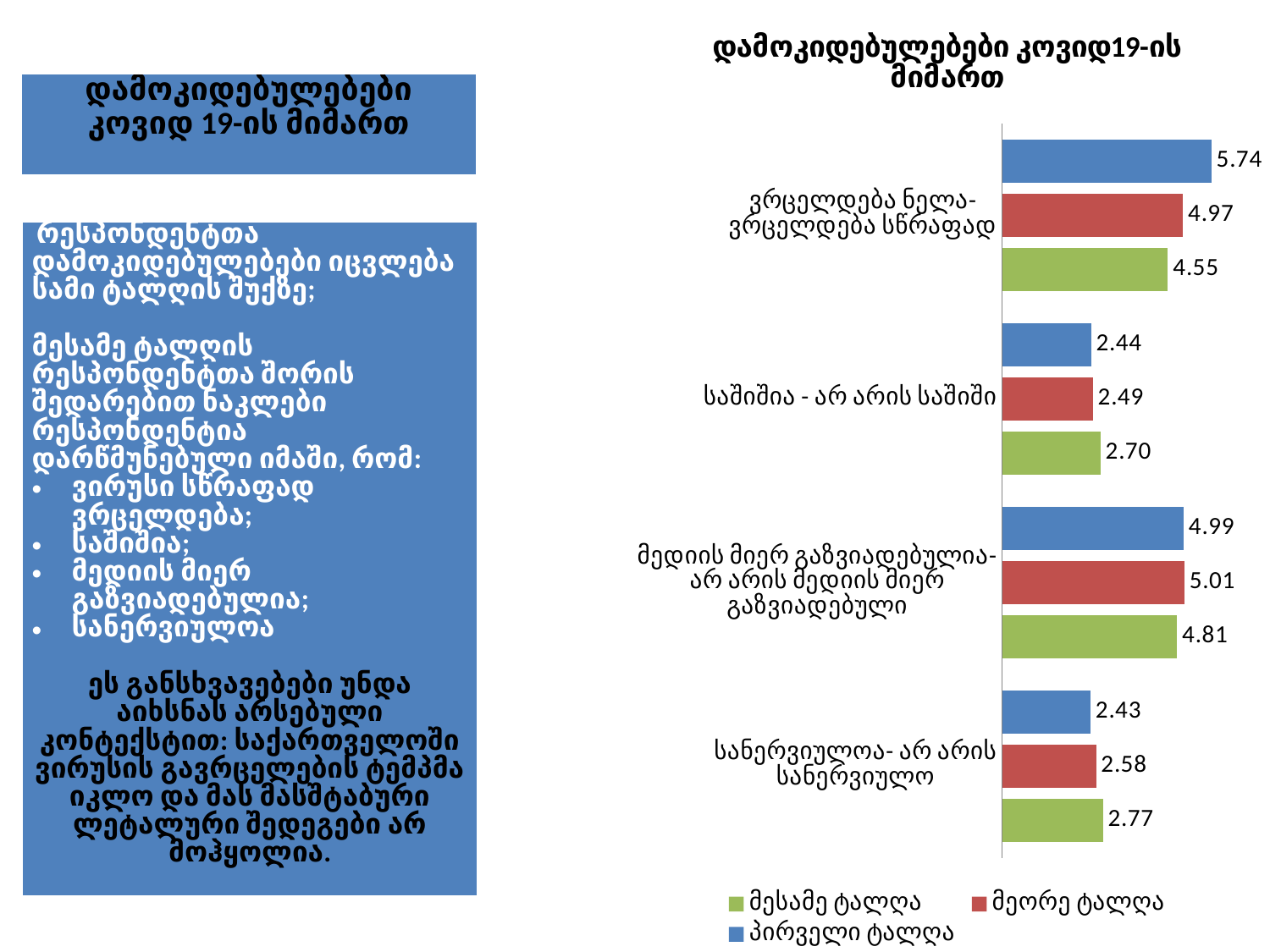
What is the value of პირველი ტალღა for ვრცელდება ნელა- ვრცელდება სწრაფად? 5.74 How many categories are shown on the chart? 4 What type of chart is shown on the slide? bar chart For სანერვიულოა- არ არის სანერვიულო, which is larger: მეორე ტალღა or პირველი ტალღა? მეორე ტალღა What is the difference between პირველი ტალღა and მესამე ტალღა for ვრცელდება ნელა- ვრცელდება სწრაფად? 1.19 Which category has the lowest value for მესამე ტალღა? საშიშია - არ არის საშიში What is the value of მესამე ტალღა for საშიშია - არ არის საშიში? 2.70 How many series does the legend list? 3 What colour are the bars for მეორე ტალღა? red Which category has the highest value for პირველი ტალღა? ვრცელდება ნელა- ვრცელდება სწრაფად What is the value of მესამე ტალღა for სანერვიულოა- არ არის სანერვიულო? 2.77 What is the value of მეორე ტალღა for მედიის მიერ გაზვიადებულია- არ არის მედიის მიერ გაზვიადებული? 5.01